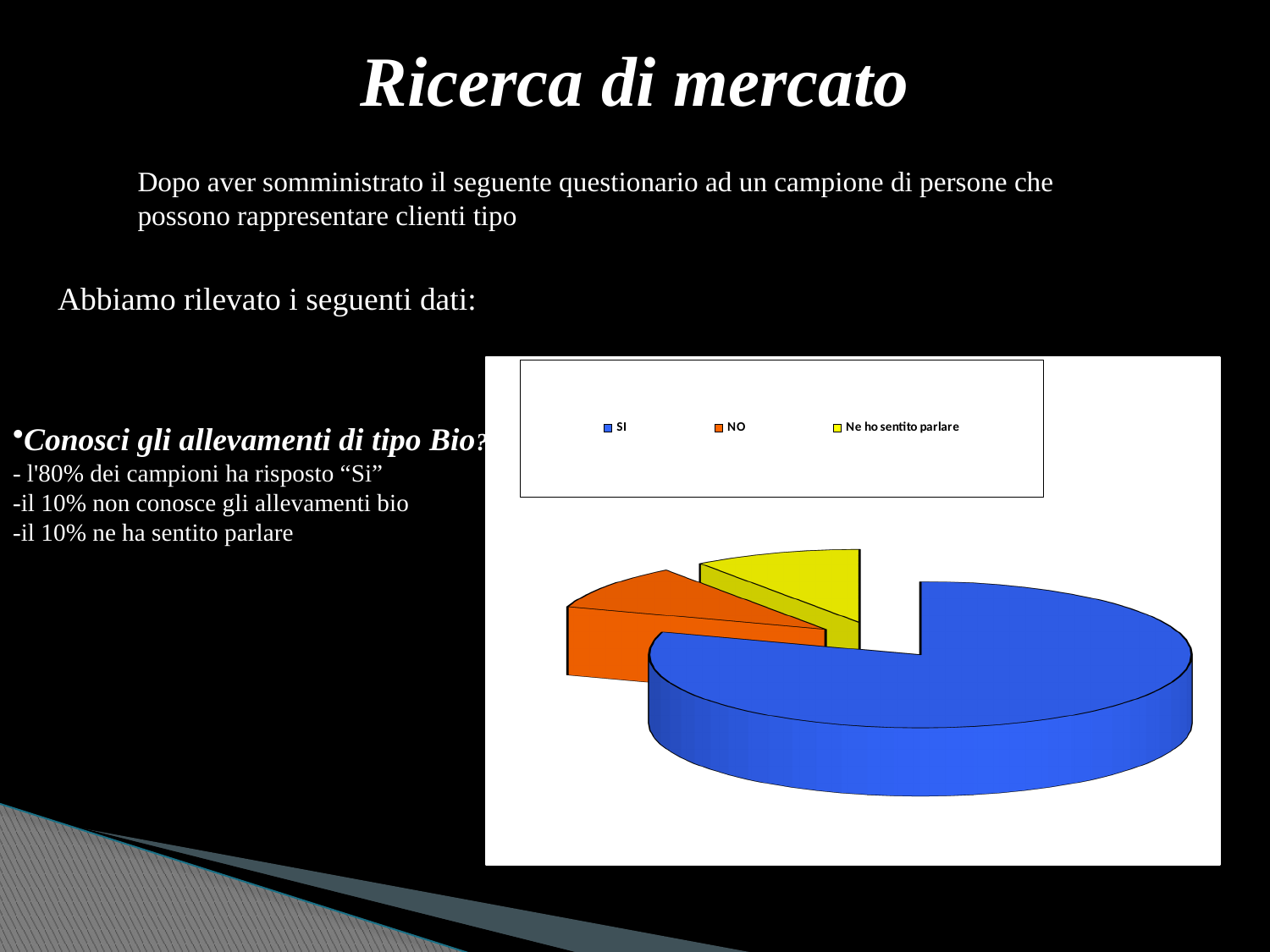
How many entries does the legend of the pie chart list? 3 What colour is the SI slice in the pie chart? blue Which slice is larger in the pie chart, SI or NO? SI How many slices does the pie chart have? 3 Which category has the largest slice in the pie chart? SI What share of the pie does the Ne ho sentito parlare slice represent? 10% What share of the pie does the NO slice represent? 10% What are the three legend entries of the pie chart? SI, NO, Ne ho sentito parlare What share of the pie does the SI slice represent? 80% What kind of chart is shown on the slide? pie chart Which slice is larger in the pie chart, SI or Ne ho sentito parlare? SI